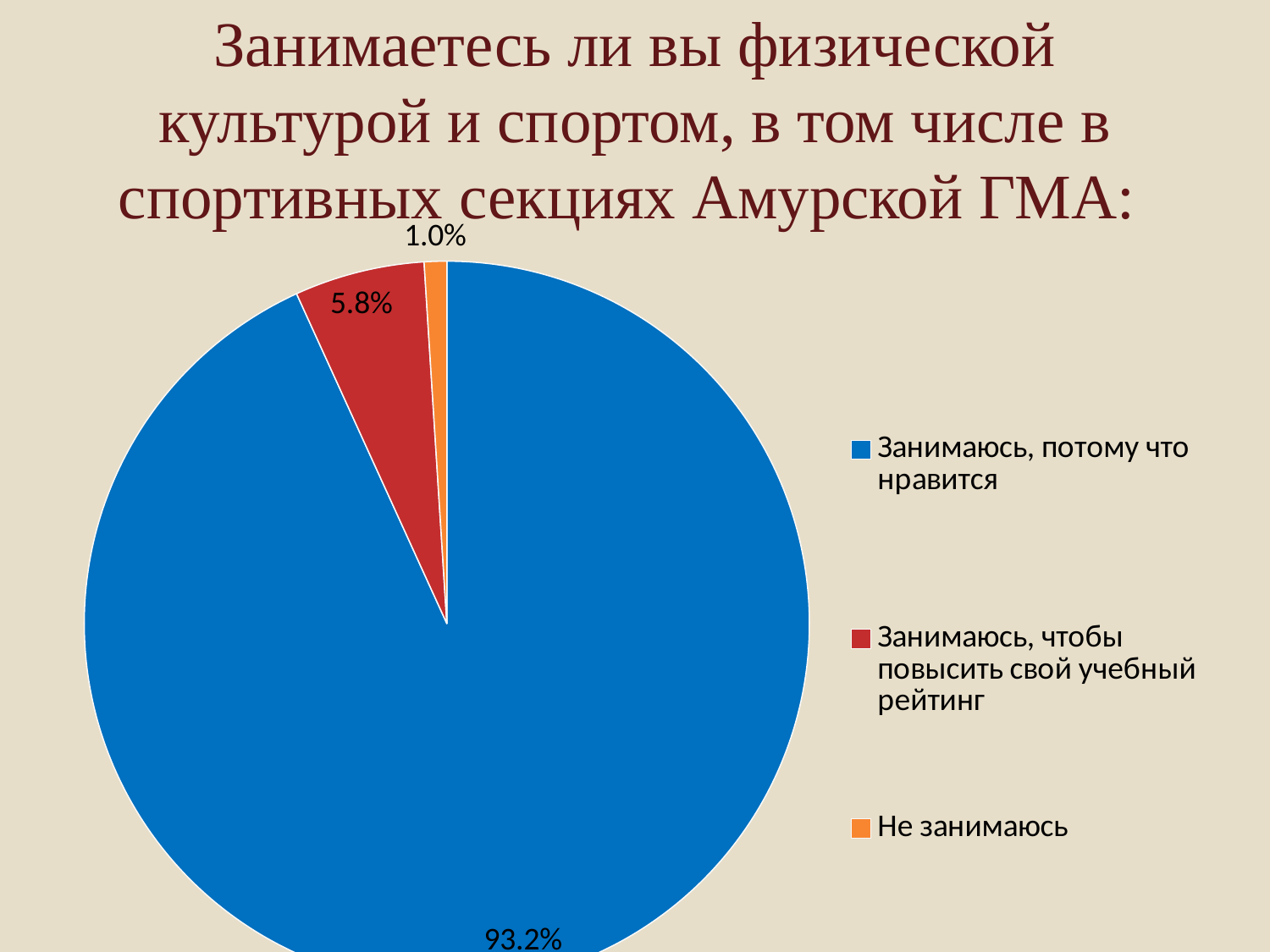
What share of the pie is labelled "Не занимаюсь"? 1.0% How many slices does the pie chart have? 3 What colour is the slice for "Не занимаюсь"? orange What share of the pie is labelled "Занимаюсь, чтобы повысить свой учебный рейтинг"? 5.8% What is the difference between the shares for "Занимаюсь, чтобы повысить свой учебный рейтинг" and "Не занимаюсь"? 4.8% Which category has the largest slice of the pie? Занимаюсь, потому что нравится Which category has the smallest slice of the pie? Не занимаюсь What share of the pie is labelled "Занимаюсь, потому что нравится"? 93.2% How many entries does the legend list? 3 Which is larger: the share for "Занимаюсь, чтобы повысить свой учебный рейтинг" or the share for "Не занимаюсь"? Занимаюсь, чтобы повысить свой учебный рейтинг What kind of chart is shown on the slide? pie chart What is the difference between the shares for "Занимаюсь, потому что нравится" and "Занимаюсь, чтобы повысить свой учебный рейтинг"? 87.4%